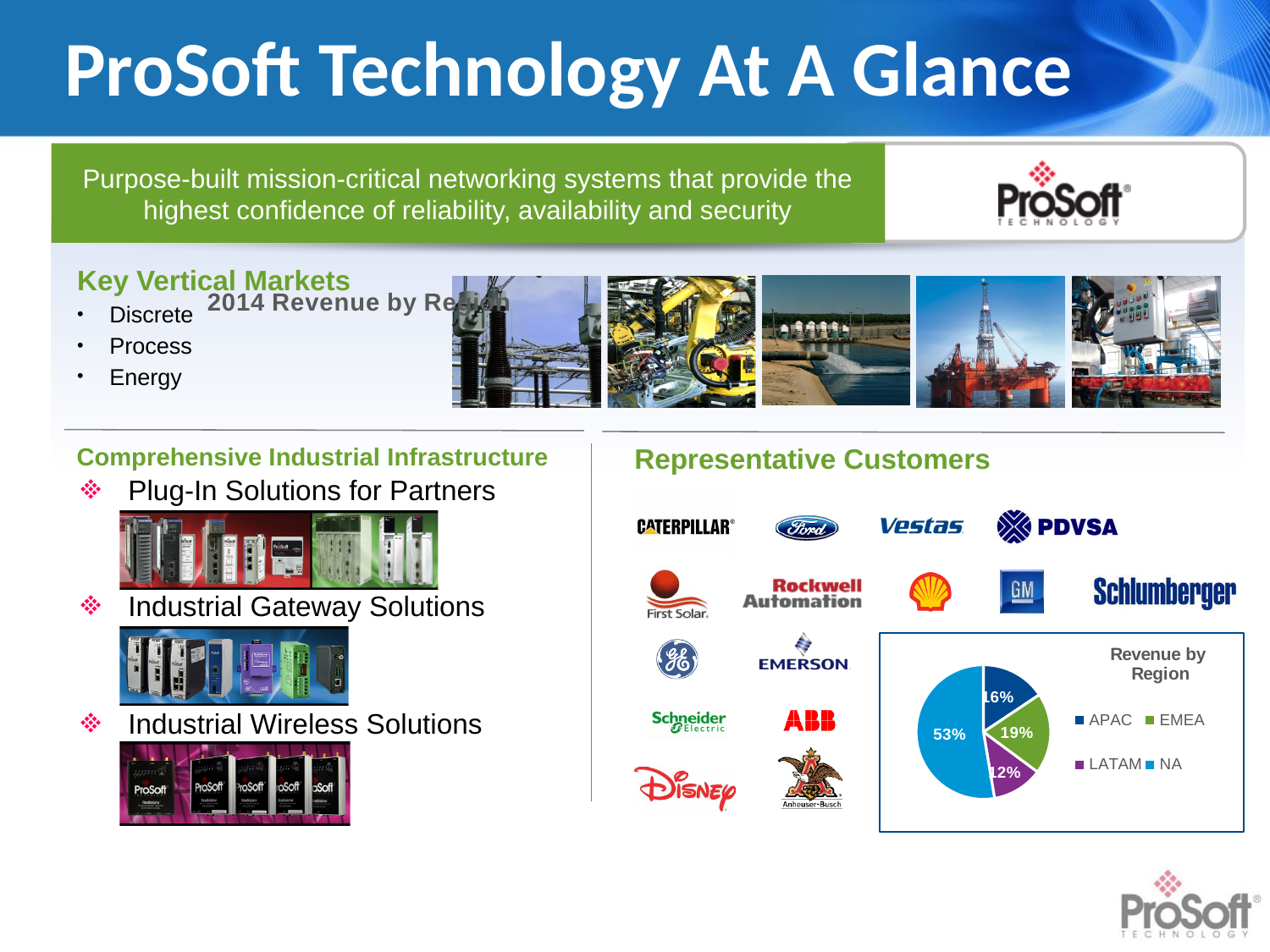
What regions are listed in the legend of the "Revenue by Region" pie chart? APAC, EMEA, LATAM, NA In the "Revenue by Region" pie chart, what share of revenue comes from LATAM? 12% In the "Revenue by Region" pie chart, which is larger, the APAC share or the EMEA share? EMEA In the "Revenue by Region" pie chart, what share of revenue comes from APAC? 16% In the "Revenue by Region" pie chart, what share of revenue comes from EMEA? 19% How many regions are shown in the "Revenue by Region" pie chart? 4 Which region has the smallest slice in the "Revenue by Region" pie chart? LATAM Which region has the largest slice in the "Revenue by Region" pie chart? NA What kind of chart is the "Revenue by Region" chart? pie chart In the "Revenue by Region" pie chart, how many percentage points larger is NA's share than EMEA's share? 34 In the "Revenue by Region" pie chart, what share of revenue comes from NA? 53% In the "Revenue by Region" pie chart, what is the combined share of APAC and LATAM? 28%